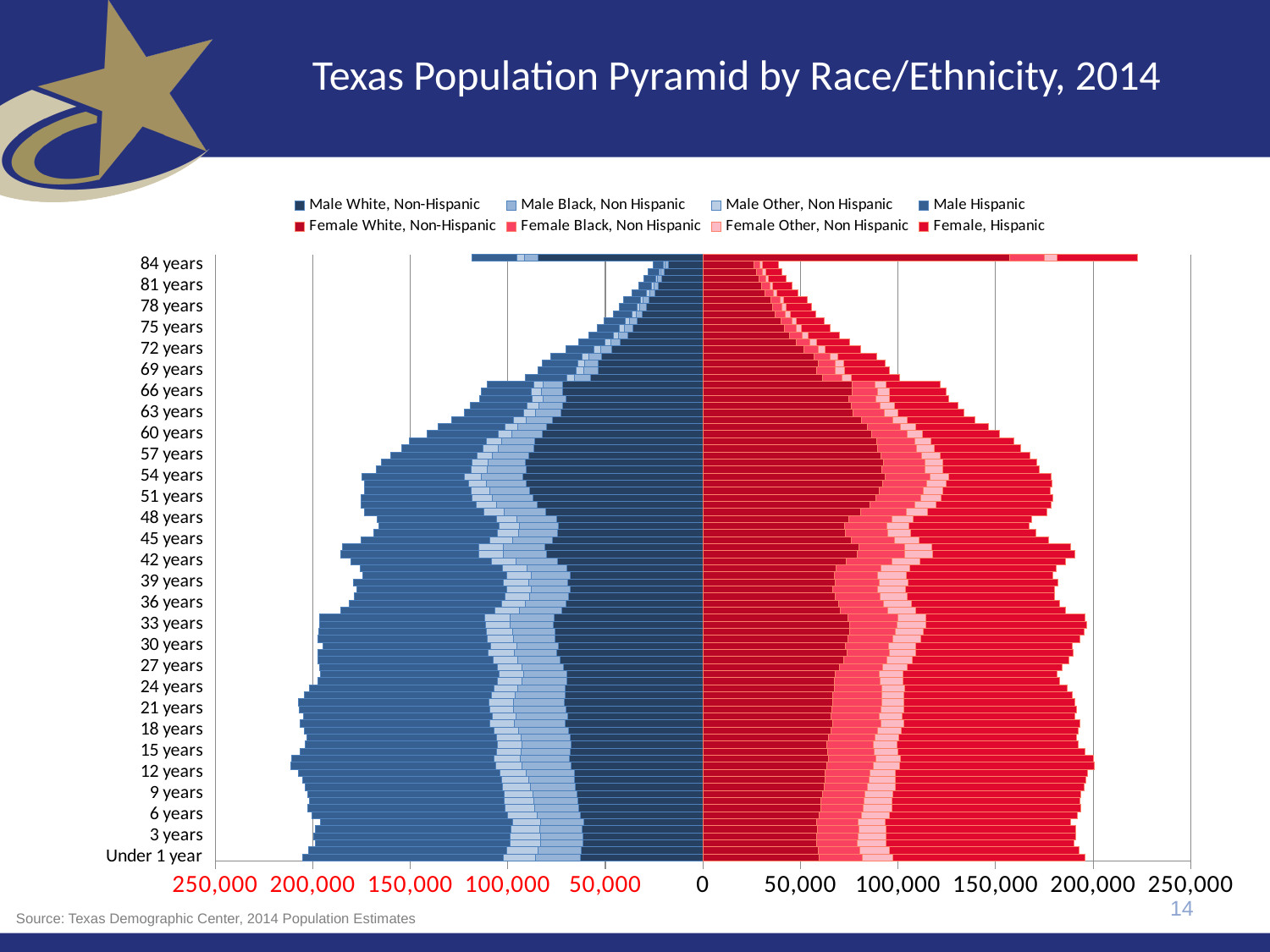
Is the total female population for the 66 years bar greater or less than 100,000? greater Which legend entry is listed last? Female, Hispanic Is the total male population for the 12 years bar greater or less than 200,000? greater What kind of chart is shown on the slide? Bar chart (population pyramid) How many series does the legend list? 8 At 84 years, which side has the longer bar, male or female? Female What is the title of the chart? Texas Population Pyramid by Race/Ethnicity, 2014 Is the total male population for the 81 years bar greater or less than 50,000? less Moving from 84 years down to Under 1 year, do the bars generally get longer or shorter? Longer